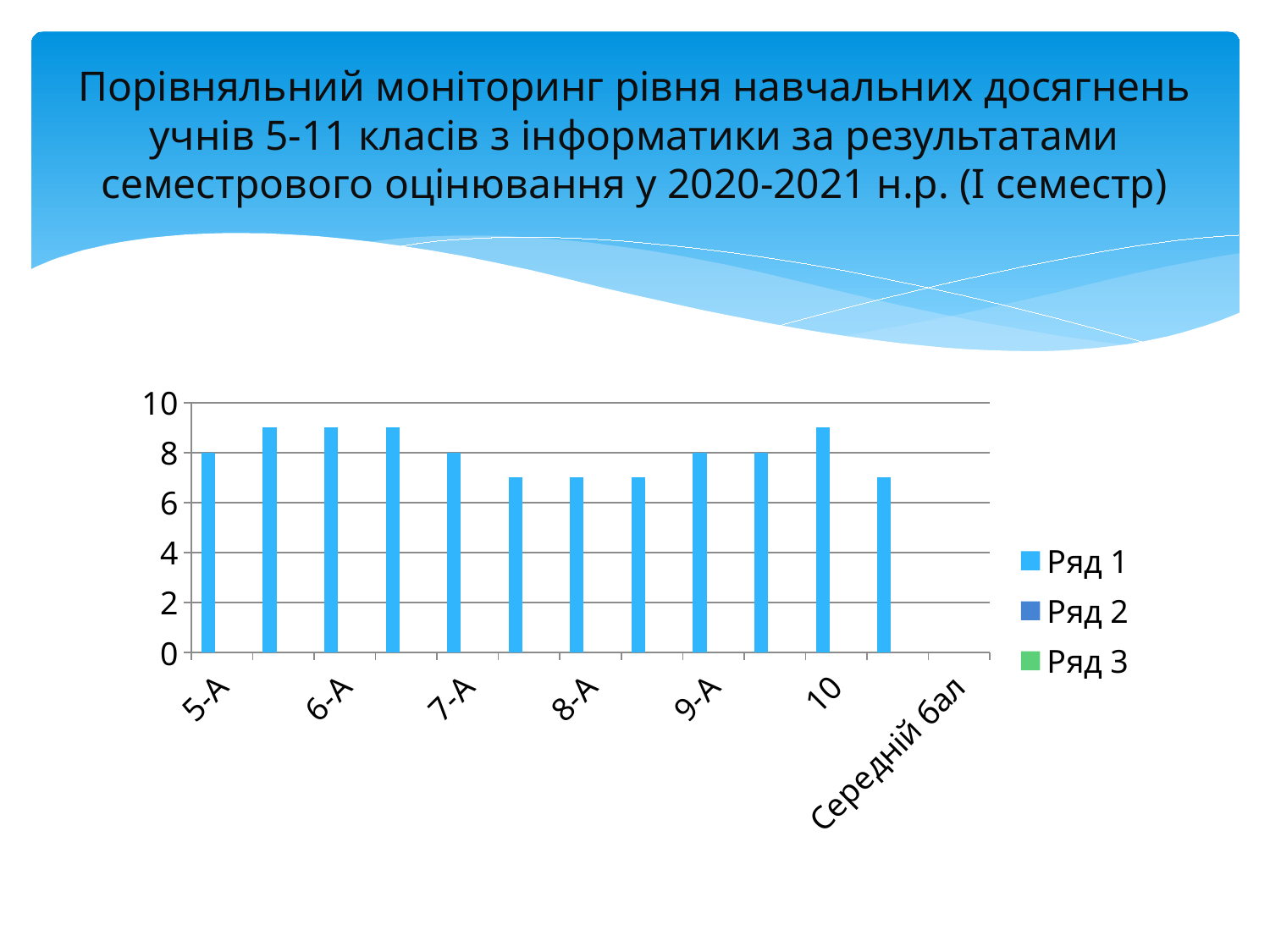
What are the entries listed in the legend? Ряд 1, Ряд 2, Ряд 3 What kind of chart is shown on the slide? bar chart Which is larger, the value for 6-А or the value for 8-А? 6-А What is the value for 7-А? 8 Is the value for 10 greater or less than 8? greater How many bars are plotted in the chart? 12 Is the value for 6-А greater or less than 8? greater How many series does the legend list? 3 What is the value for 5-А? 8 Is the value for 8-А greater or less than 8? less Which is larger, the value for 5-А or the value for 6-А? 6-А What is the value for 9-А? 8